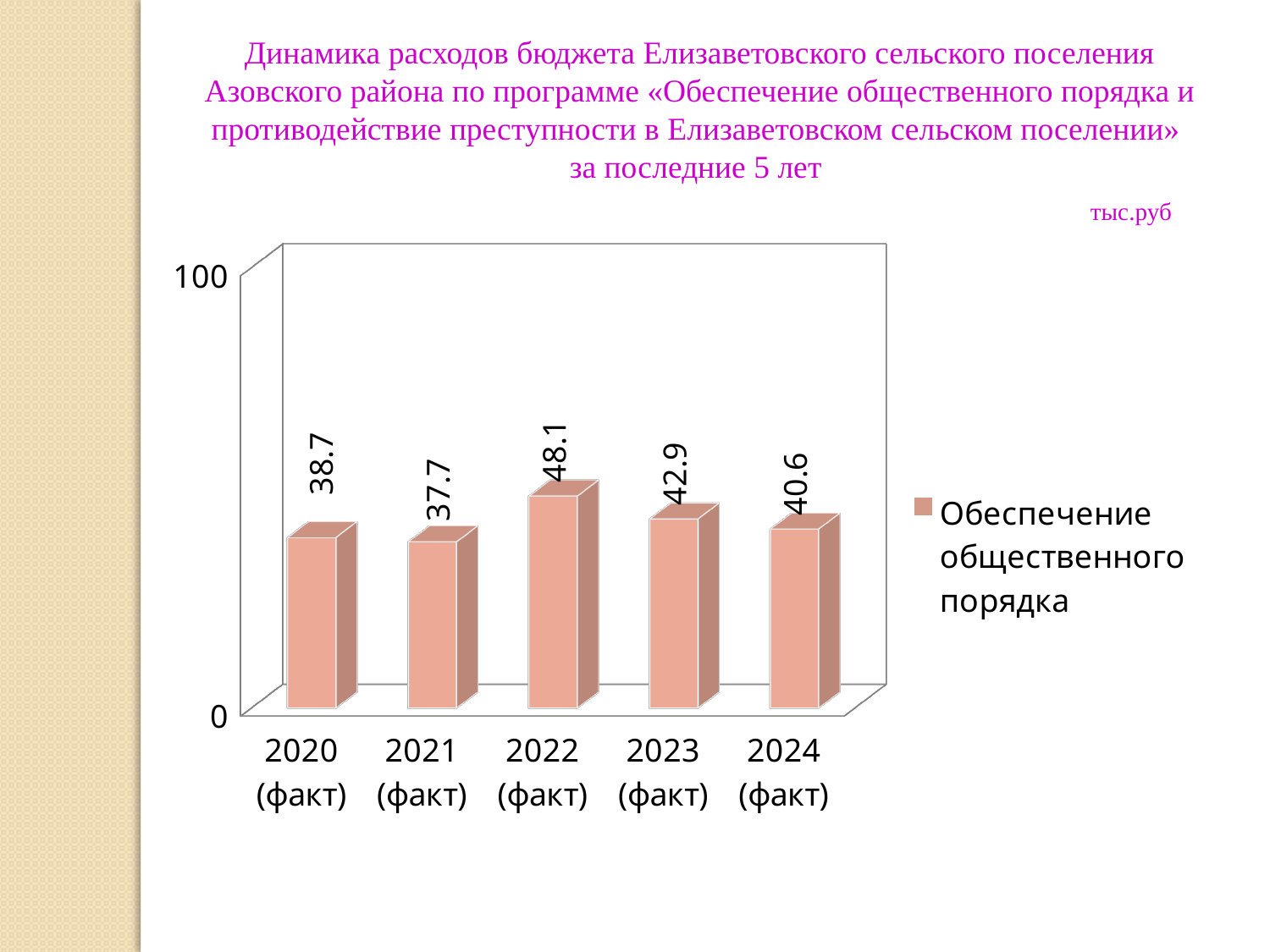
Which year has the highest value? 2022 (факт) What is the difference between the values for 2023 (факт) and 2024 (факт)? 2.3 Which is larger, the value for 2020 (факт) or the value for 2023 (факт)? 2023 (факт) What is the difference between the values for 2022 (факт) and 2021 (факт)? 10.4 Which year has the lowest value? 2021 (факт) What is the value for 2022 (факт)? 48.1 How many years are shown on the x axis? 5 What is the value for 2024 (факт)? 40.6 What kind of chart is shown on the slide? bar chart What is the value for 2020 (факт)? 38.7 Is the value for 2022 (факт) greater or less than 100? less How many series does the legend list? 1